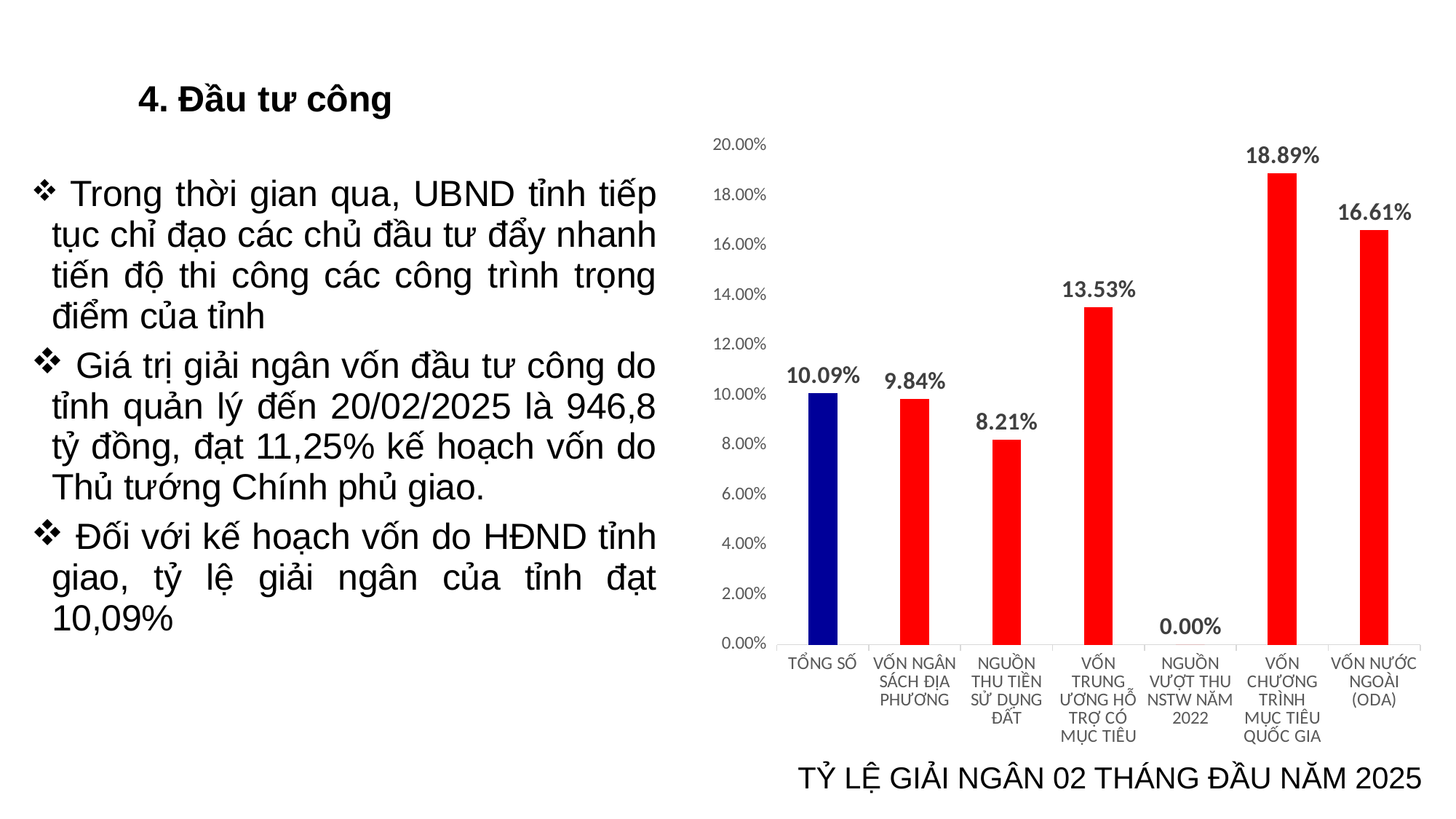
What is the title of the chart? TỶ LỆ GIẢI NGÂN 02 THÁNG ĐẦU NĂM 2025 How many categories are shown on the x axis of the chart? 7 Which category has the lowest value in the chart? NGUỒN VƯỢT THU NSTW NĂM 2022 What is the value for TỔNG SỐ in the chart? 10.09% What is the difference between the values for VỐN CHƯƠNG TRÌNH MỤC TIÊU QUỐC GIA and VỐN NƯỚC NGOÀI (ODA)? 2.28% What is the value for NGUỒN VƯỢT THU NSTW NĂM 2022? 0.00% What is the value for VỐN NƯỚC NGOÀI (ODA)? 16.61% Which category has the highest value in the chart? VỐN CHƯƠNG TRÌNH MỤC TIÊU QUỐC GIA What is the difference between the values for VỐN TRUNG ƯƠNG HỖ TRỢ CÓ MỤC TIÊU and VỐN NGÂN SÁCH ĐỊA PHƯƠNG? 3.69% Which is larger, the value for VỐN TRUNG ƯƠNG HỖ TRỢ CÓ MỤC TIÊU or the value for VỐN NGÂN SÁCH ĐỊA PHƯƠNG? VỐN TRUNG ƯƠNG HỖ TRỢ CÓ MỤC TIÊU What kind of chart is shown on the slide? Bar chart What is the value for NGUỒN THU TIỀN SỬ DỤNG ĐẤT? 8.21%